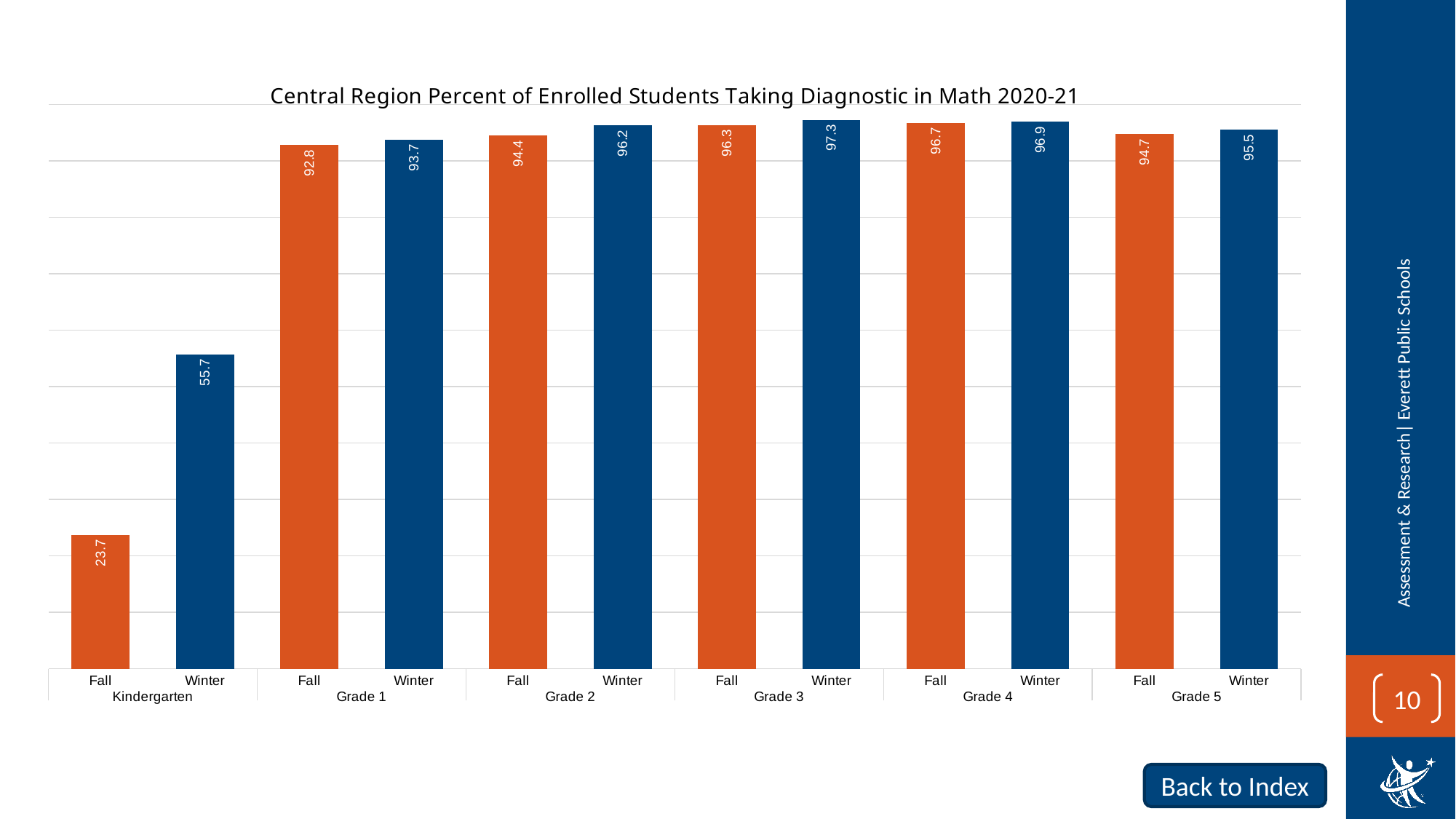
What is the difference between Grade 1 Winter and Grade 1 Fall? 0.9 What is the difference between Kindergarten Winter and Kindergarten Fall? 32.0 Which bar has the highest value? Grade 3 Winter How many grade levels are shown on the x axis? 6 Which bar has the lowest value? Kindergarten Fall What is the value for Grade 3 Winter? 97.3 What is the title of the chart? Central Region Percent of Enrolled Students Taking Diagnostic in Math 2020-21 What is the value for Kindergarten Fall? 23.7 What kind of chart is this? bar chart What is the value for Grade 5 Fall? 94.7 How many bars are plotted in total? 12 Which is larger, Grade 2 Fall or Grade 4 Fall? Grade 4 Fall